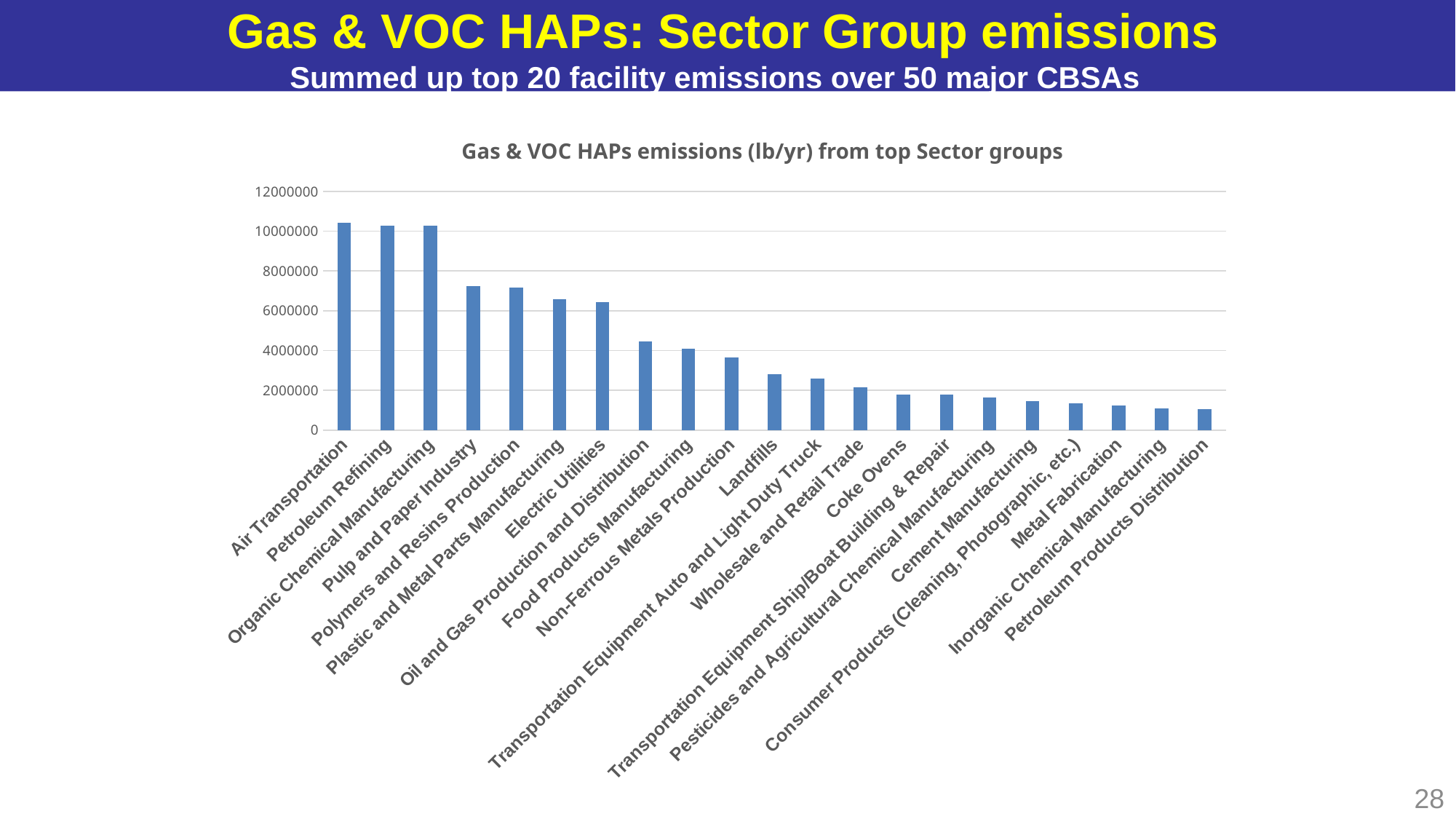
Is the value for Landfills greater or less than 2000000? greater Is the value for Metal Fabrication greater or less than 2000000? less Is the value for Coke Ovens greater or less than 2000000? less What kind of chart is shown on the slide? bar chart Which has the larger value, Pulp and Paper Industry or Landfills? Pulp and Paper Industry How many sector groups are plotted in the chart? 21 Which has the larger value, Electric Utilities or Oil and Gas Production and Distribution? Electric Utilities Do the bar values rise or fall from left to right along the x axis? fall What is the title of the chart? Gas & VOC HAPs emissions (lb/yr) from top Sector groups